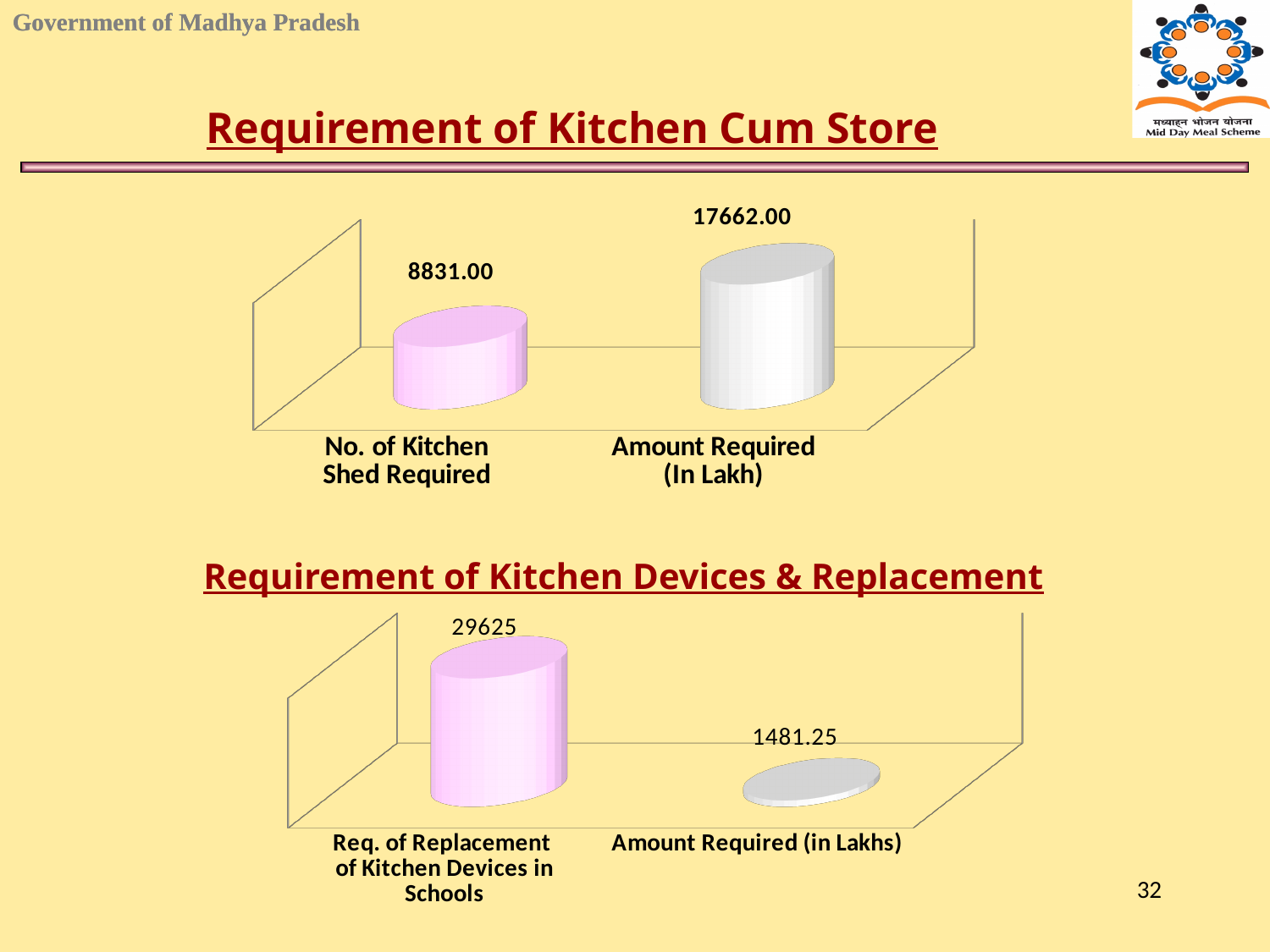
In the 'Requirement of Kitchen Devices & Replacement' chart, which category has the lower value? Amount Required (in Lakhs) In the 'Requirement of Kitchen Devices & Replacement' chart, is the value for 'Req. of Replacement of Kitchen Devices in Schools' larger or smaller than the value for 'Amount Required (in Lakhs)'? larger In the 'Requirement of Kitchen Devices & Replacement' chart, what is the difference between the 'Req. of Replacement of Kitchen Devices in Schools' and 'Amount Required (in Lakhs)' values? 28143.75 In the 'Requirement of Kitchen Cum Store' chart, what is the value for 'Amount Required (In Lakh)'? 17662.00 In the 'Requirement of Kitchen Devices & Replacement' chart, what is the value for 'Req. of Replacement of Kitchen Devices in Schools'? 29625 How many charts are shown on the slide? 2 In the 'Requirement of Kitchen Devices & Replacement' chart, what is the value for 'Amount Required (in Lakhs)'? 1481.25 In the 'Requirement of Kitchen Cum Store' chart, what is the difference between the 'Amount Required (In Lakh)' and 'No. of Kitchen Shed Required' values? 8831.00 In the 'Requirement of Kitchen Cum Store' chart, how many categories are plotted? 2 In the 'Requirement of Kitchen Cum Store' chart, which category has the higher value? Amount Required (In Lakh) What kind of chart is the 'Requirement of Kitchen Cum Store' chart? bar chart In the 'Requirement of Kitchen Cum Store' chart, what is the value for 'No. of Kitchen Shed Required'? 8831.00